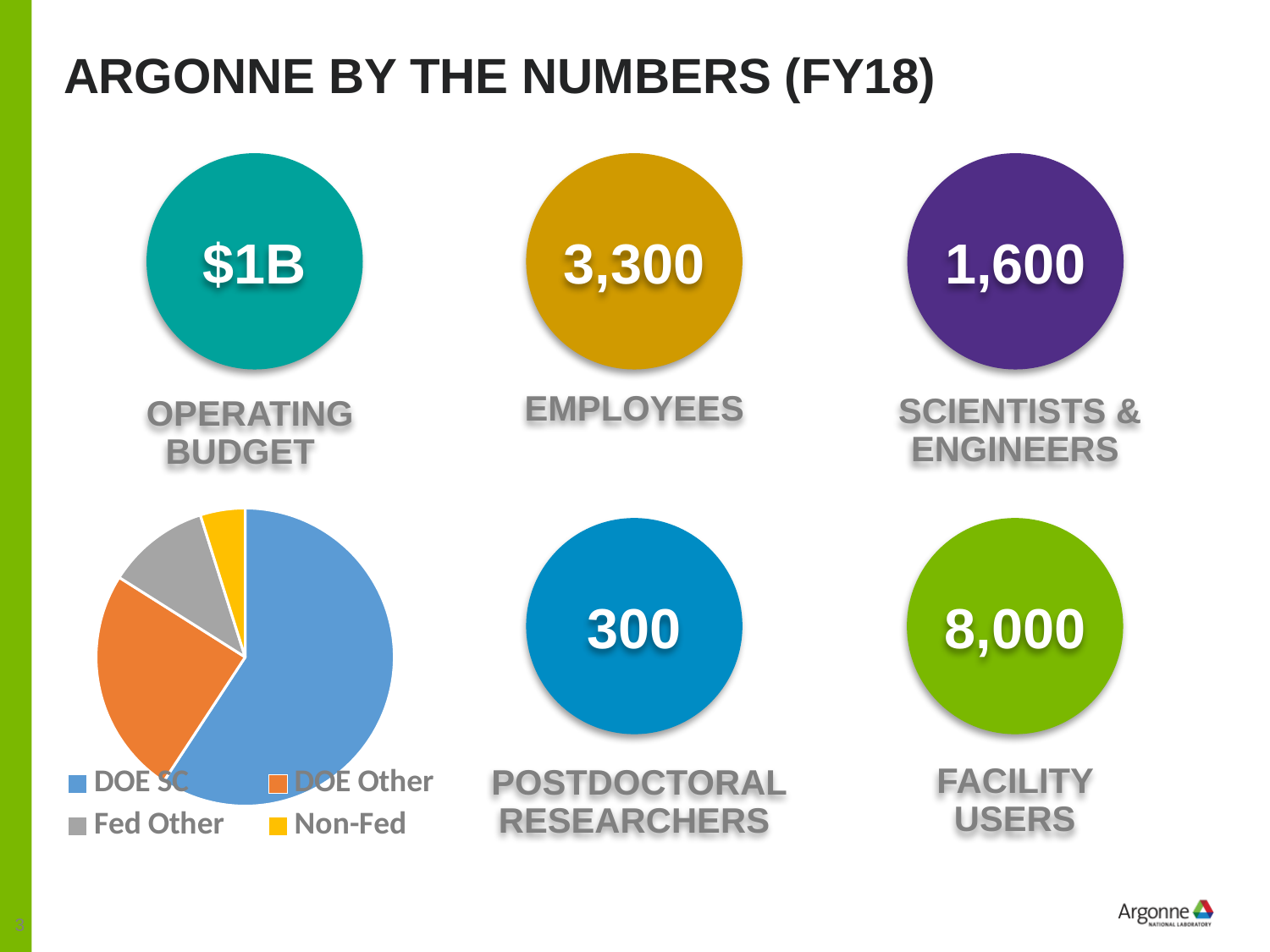
What kind of chart is shown on the slide? pie chart In the pie chart, which is larger: DOE SC or DOE Other? DOE SC What colour is the DOE SC slice in the pie chart? blue Which category has the smallest slice of the pie chart? Non-Fed How many slices does the pie chart have? 4 Which category has the largest slice of the pie chart? DOE SC In the pie chart, which is larger: DOE Other or Fed Other? DOE Other How many entries does the pie chart's legend list? 4 In the pie chart, which is larger: Fed Other or Non-Fed? Fed Other Which legend entry in the pie chart is shown in yellow? Non-Fed